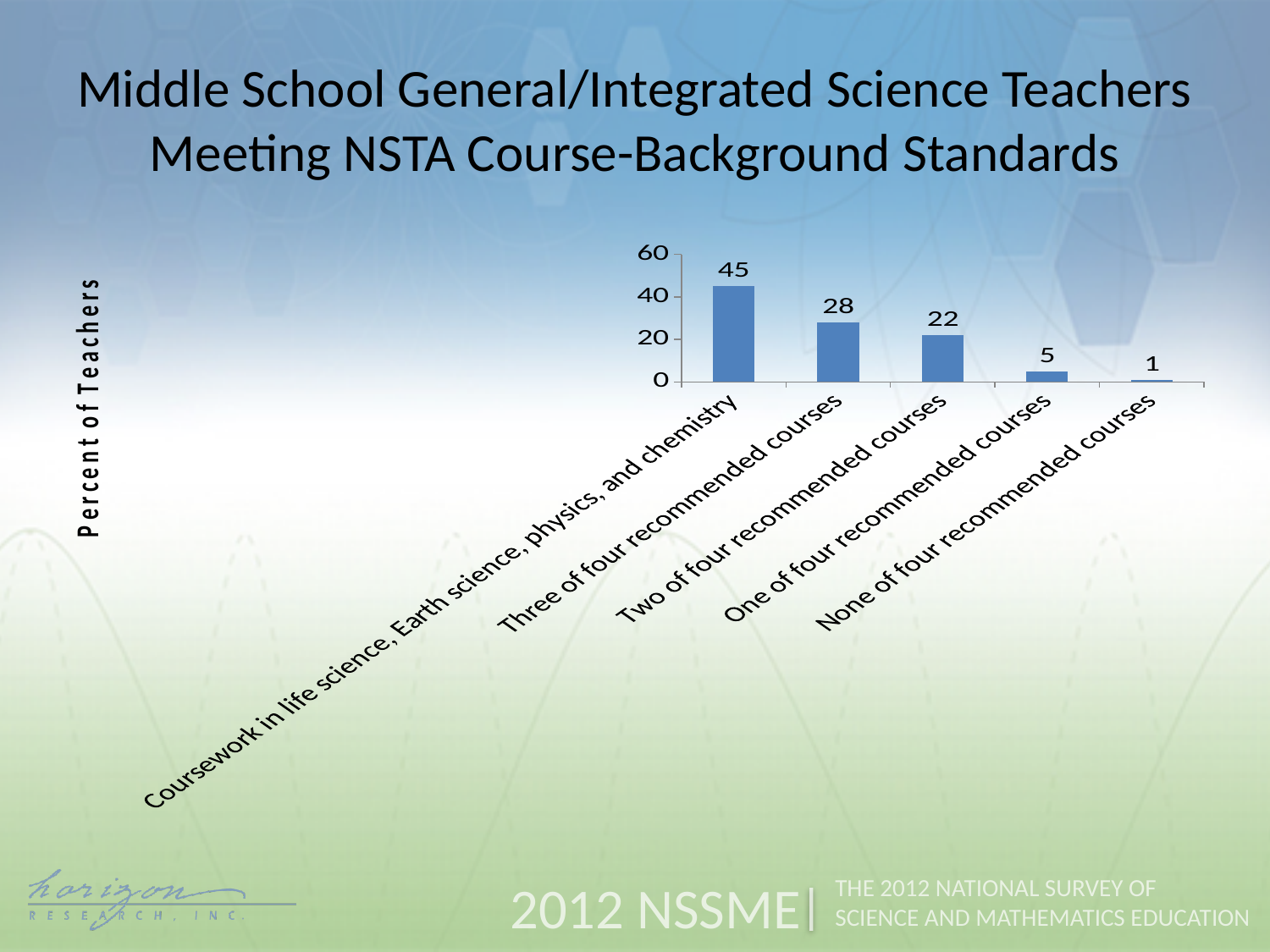
What is the difference between the values for 'Three of four recommended courses' and 'One of four recommended courses'? 23 Is the value for 'Coursework in life science, Earth science, physics, and chemistry' greater or less than 40? greater Which is larger: the value for 'Two of four recommended courses' or 'One of four recommended courses'? Two of four recommended courses How many categories are shown on the x axis? 5 What is the label of the vertical axis? Percent of Teachers What is the value for 'None of four recommended courses'? 1 Which category has the highest value? Coursework in life science, Earth science, physics, and chemistry What kind of chart is shown on the slide? Bar chart What is the value for 'Two of four recommended courses'? 22 What percent of teachers had coursework in life science, Earth science, physics, and chemistry? 45 Which category has the lowest value? None of four recommended courses What is the value for 'Three of four recommended courses'? 28